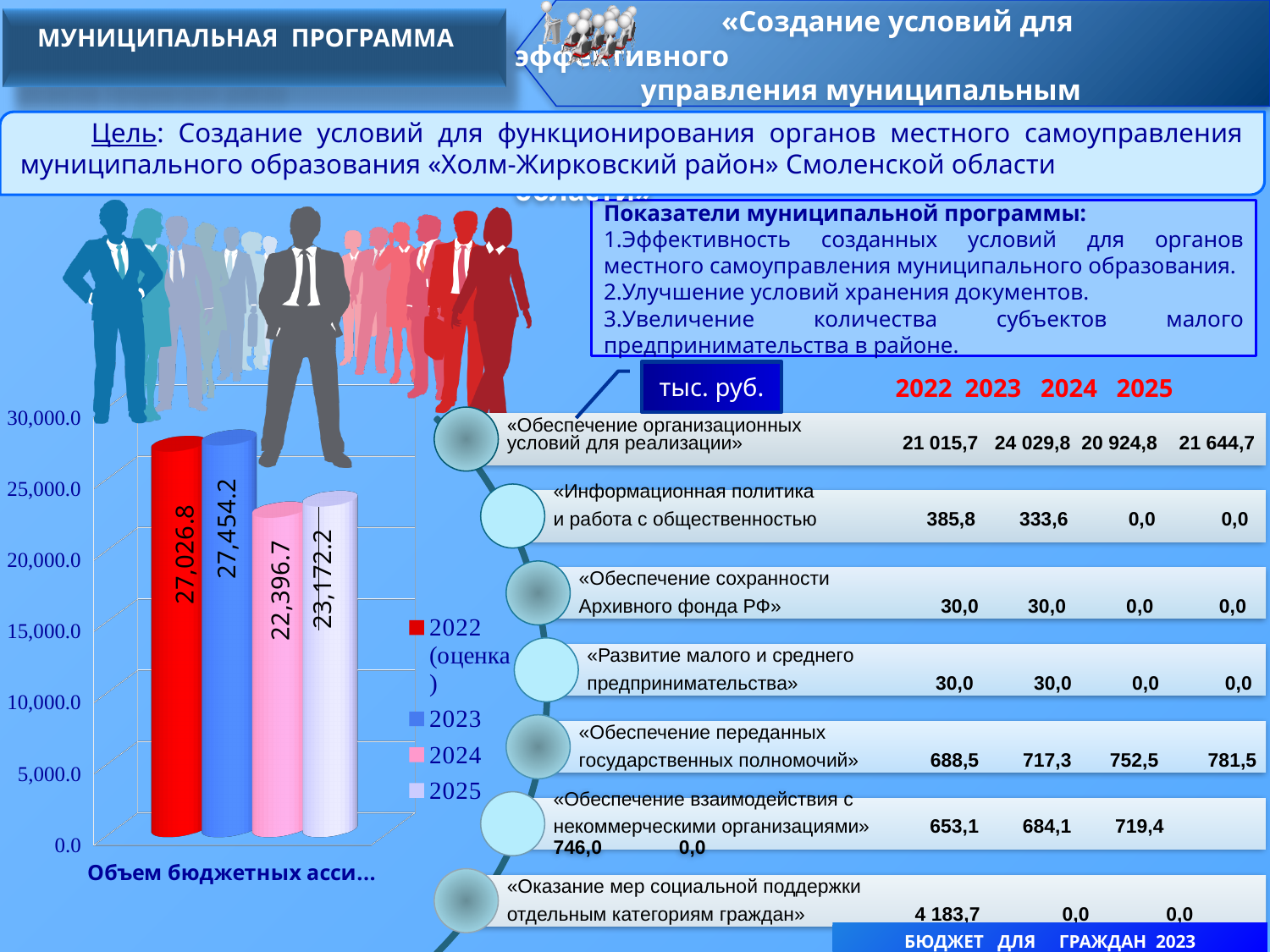
What is the value of the 2023 bar in the bar chart? 27,454.2 What is the value of the 2022 (оценка) bar in the bar chart? 27,026.8 Which year has the lowest bar in the bar chart? 2024 What is the difference between the 2025 and 2024 values in the bar chart? 775.5 Which year has the highest bar in the bar chart? 2023 What is the difference between the 2023 and 2022 (оценка) values in the bar chart? 427.4 Is the value for 2024 in the bar chart greater or less than 25,000.0? less Which is larger in the bar chart, the 2024 value or the 2025 value? 2025 What is the value of the 2025 bar in the bar chart? 23,172.2 How many series does the legend of the bar chart list? 4 What is the value of the 2024 bar in the bar chart? 22,396.7 What type of chart is shown on the left of the slide? bar chart